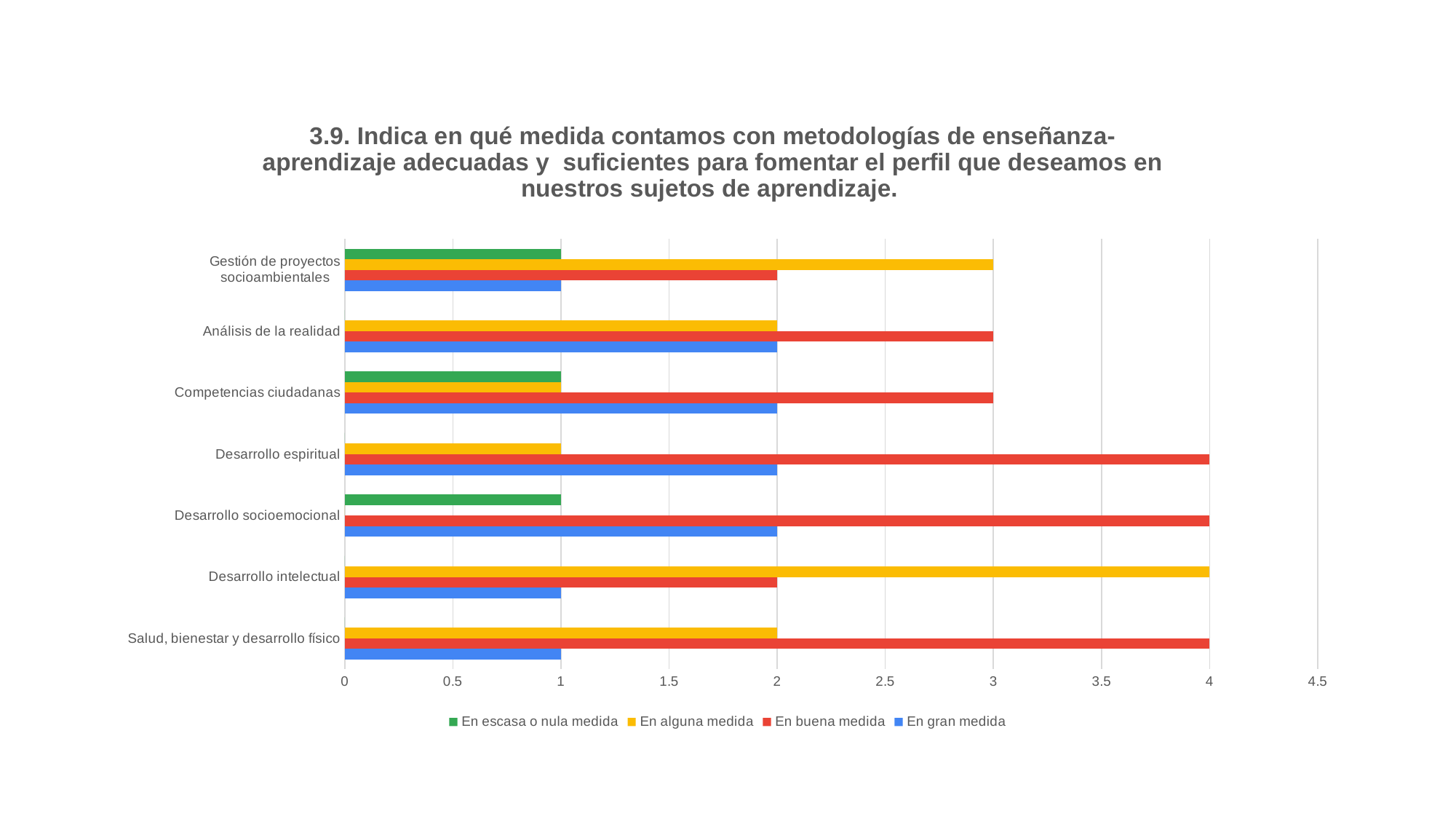
For Análisis de la realidad, which is larger: 'En buena medida' or 'En alguna medida'? En buena medida Which category has the highest value for 'En alguna medida'? Desarrollo intelectual What is the value of 'En alguna medida' for Desarrollo intelectual? 4 What kind of chart is shown on the slide? bar chart How many categories are shown on the vertical axis of the chart? 7 How many series does the legend list? 4 Is the value of 'En buena medida' for Competencias ciudadanas greater or less than 2? greater What is the value of 'En gran medida' for Salud, bienestar y desarrollo físico? 1 What is the difference between 'En buena medida' and 'En gran medida' for Desarrollo socioemocional? 2 Which colour represents 'En escasa o nula medida' in the legend? green What is the value of 'En alguna medida' for Gestión de proyectos socioambientales? 3 What is the value of 'En buena medida' for Desarrollo espiritual? 4